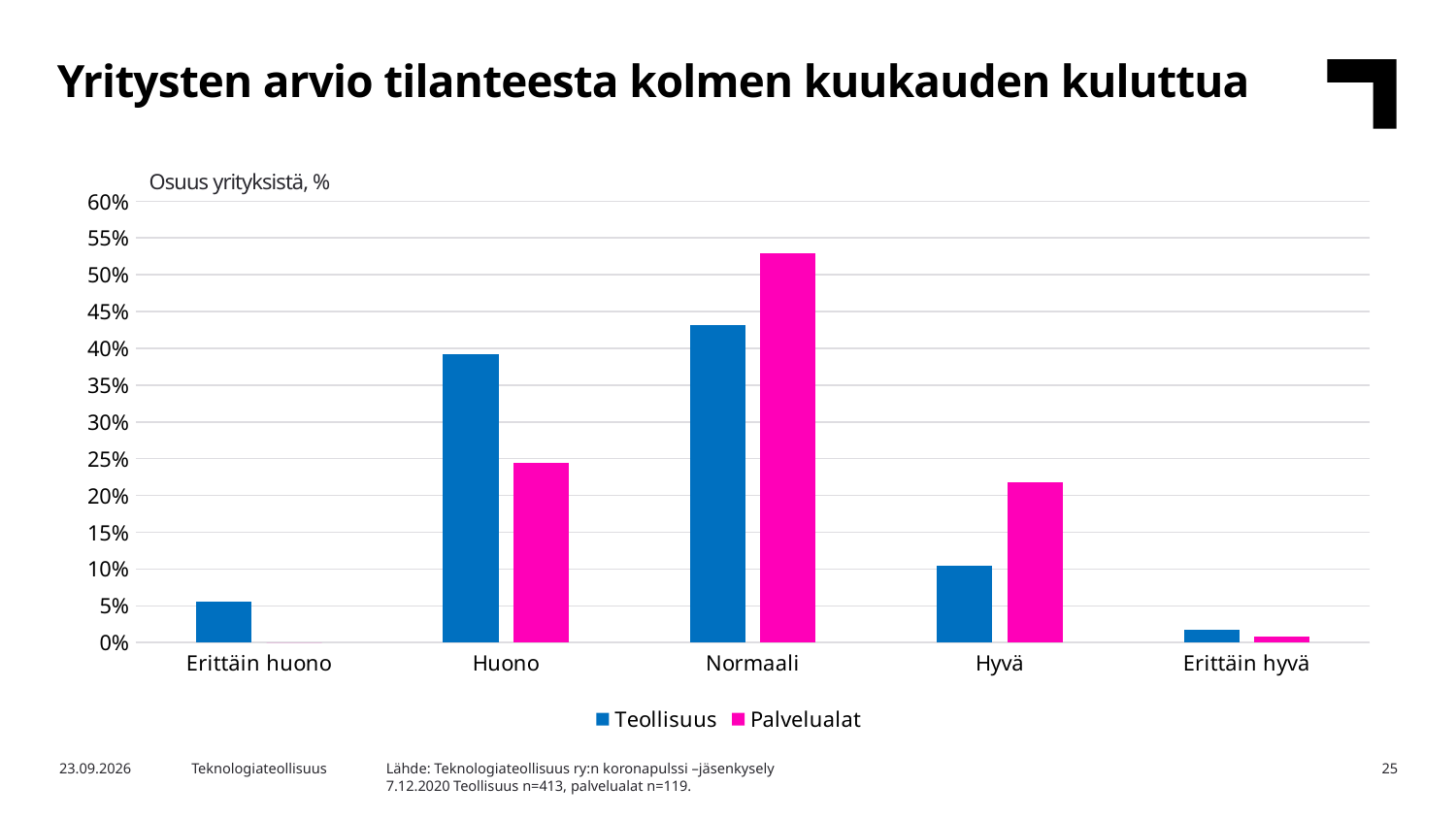
Which category has the highest value for Teollisuus? Normaali What label is shown above the vertical axis of the chart? Osuus yrityksistä, % For the category Huono, which series has the larger value, Teollisuus or Palvelualat? Teollisuus Which category has the highest value for Palvelualat? Normaali What kind of chart is shown on the slide? bar chart Is the value for Palvelualat in the category Normaali greater or less than 50%? greater Is the value for Teollisuus in the category Erittäin huono greater or less than 10%? less Is the value for Teollisuus in the category Huono greater or less than 35%? greater How many categories are shown on the x axis? 5 For the category Hyvä, which series has the larger value, Teollisuus or Palvelualat? Palvelualat Which category has the lowest value for Teollisuus? Erittäin hyvä How many series does the legend list? 2